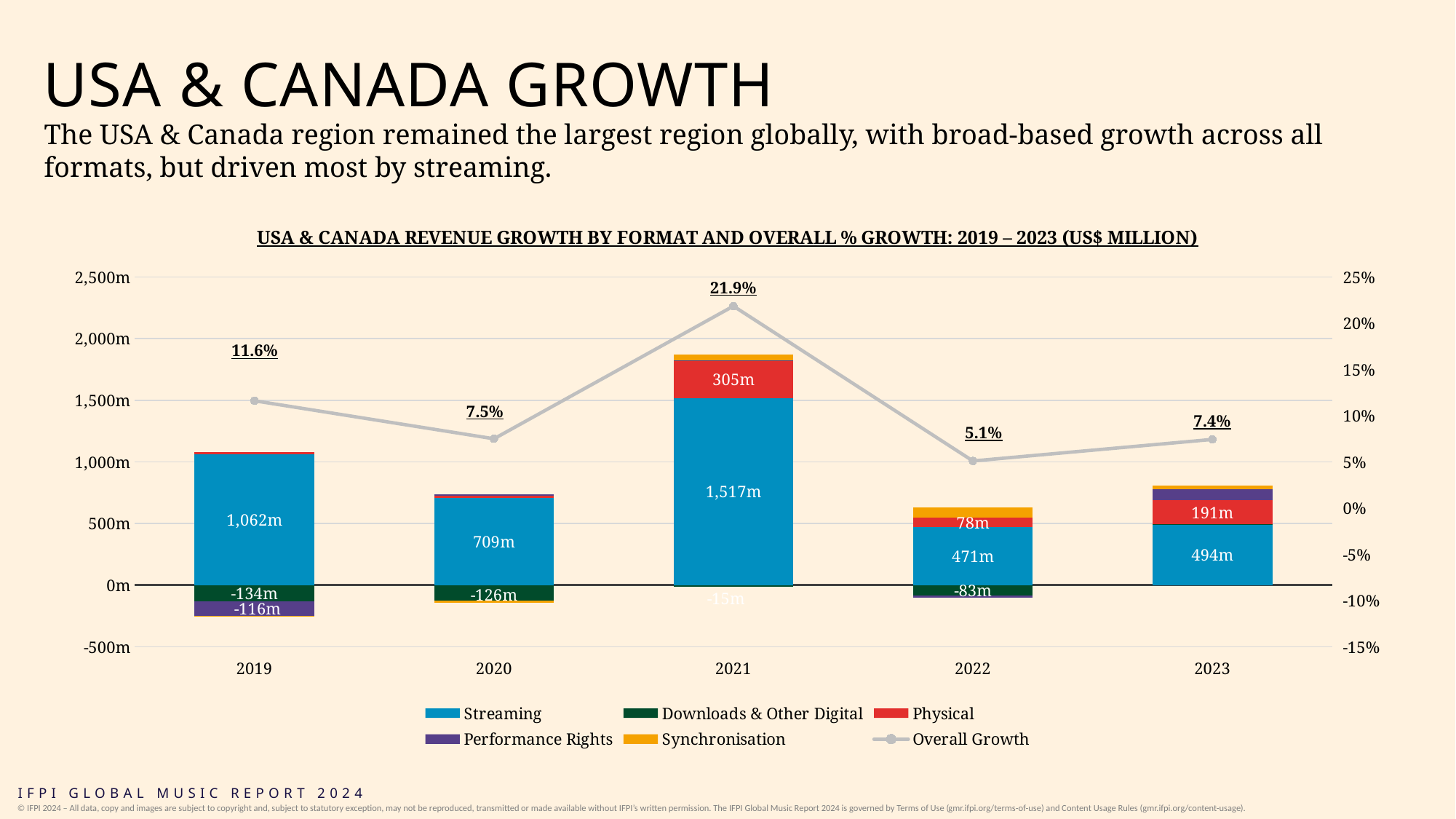
Which year has the lowest Overall Growth percentage? 2022 How many series does the legend list? 6 What is the Overall Growth percentage for 2021? 21.9% Which year has the highest Overall Growth percentage? 2021 How many years are shown on the x axis? 5 What is the Performance Rights value for 2019? -116m What is the Downloads & Other Digital value for 2019? -134m Does the Overall Growth line rise or fall from 2021 to 2022? fall Which year has the larger Physical value, 2022 or 2023? 2023 What is the difference between the Streaming value in 2021 and in 2019? 455m What is the Streaming value for 2021? 1,517m What is the difference between the Overall Growth percentage in 2021 and in 2022? 16.8%